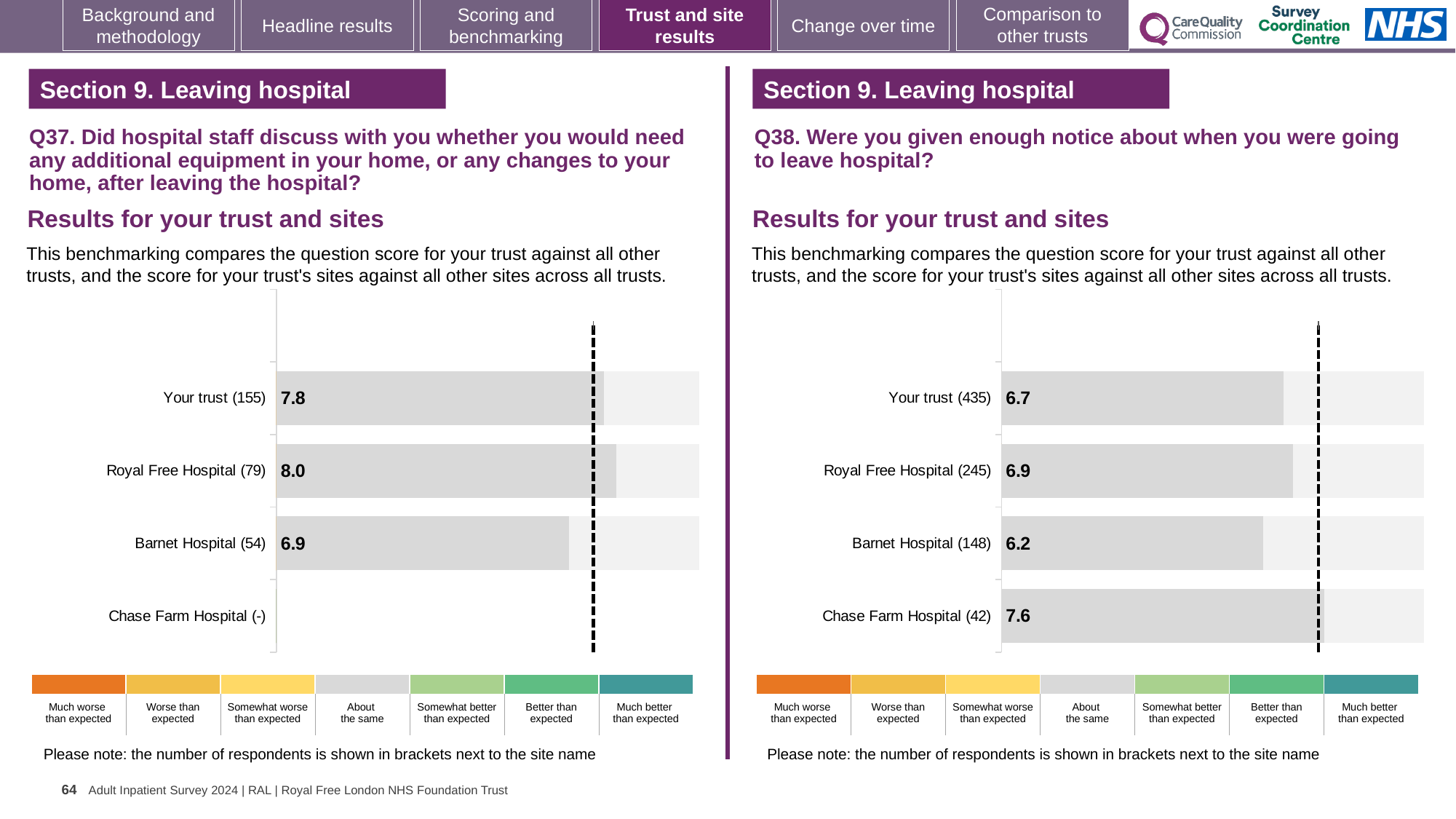
In the Q37 chart on the left, what is the score for Your trust? 7.8 In the Q38 chart on the right, which site has the highest score? Chase Farm Hospital In the Q37 chart on the left, what is the difference between the Royal Free Hospital score and the Barnet Hospital score? 1.1 In the Q37 chart on the left, what is the score for Royal Free Hospital? 8.0 In the Q38 chart on the right, what is the score for Barnet Hospital? 6.2 In the Q38 chart on the right, what is the score for Chase Farm Hospital? 7.6 What type of chart is used in the Q37 chart on the left? Bar chart How many bars are plotted in the Q38 chart on the right? 4 In the Q38 chart on the right, which is larger, the score for Your trust or the score for Royal Free Hospital? Royal Free Hospital In the Q38 chart on the right, what is the difference between the Chase Farm Hospital score and the Barnet Hospital score? 1.4 In the Q37 chart on the left, how many respondents are shown in brackets for Barnet Hospital? 54 In the Q37 chart on the left, which site with a printed score has the lowest score? Barnet Hospital